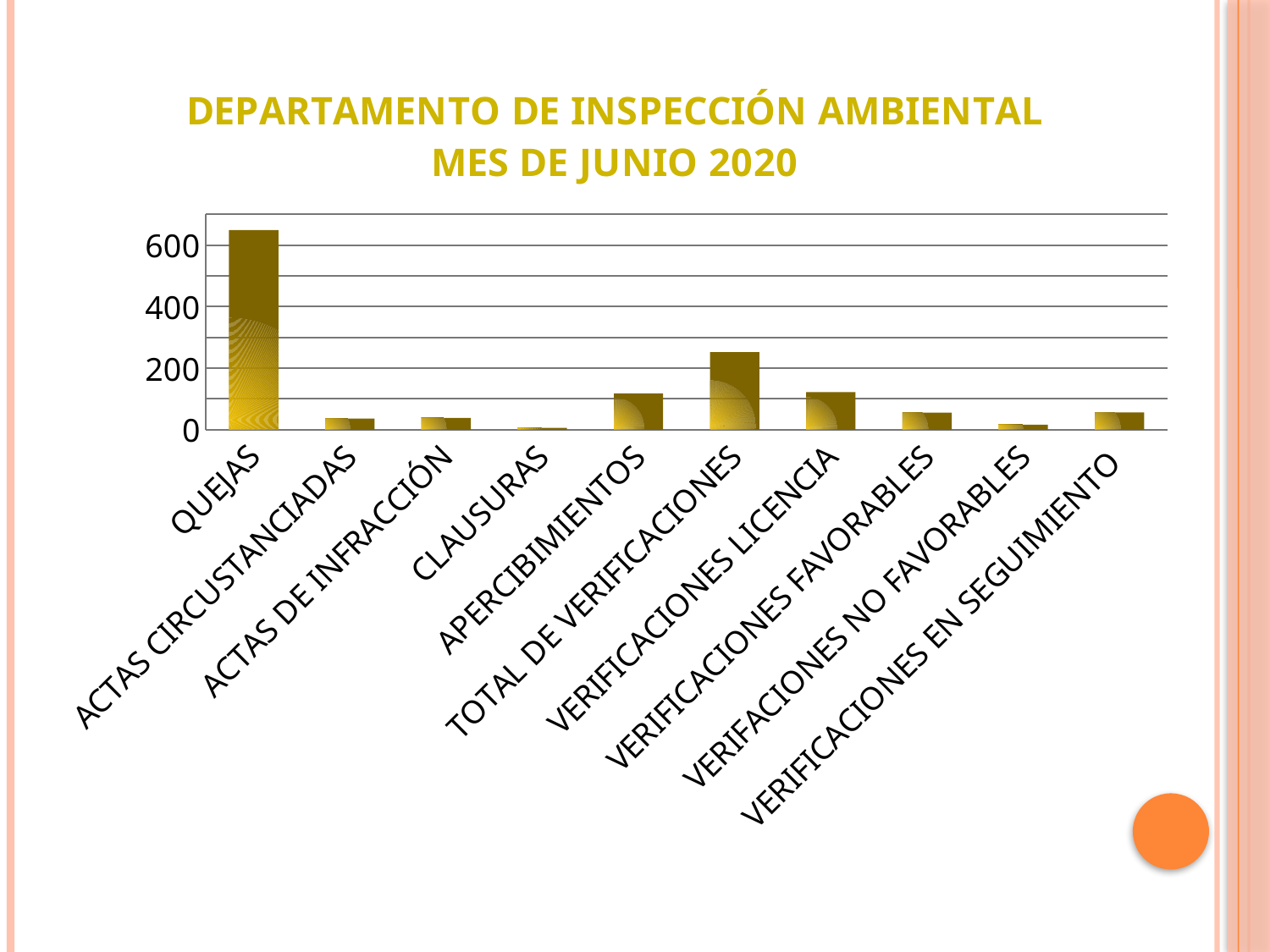
Is the value for TOTAL DE VERIFICACIONES greater or less than 200? greater Which is larger, the value for TOTAL DE VERIFICACIONES or the value for VERIFICACIONES LICENCIA? TOTAL DE VERIFICACIONES Which category has the lowest value? CLAUSURAS Is the value for QUEJAS greater or less than 600? greater Which is larger, the value for QUEJAS or the value for TOTAL DE VERIFICACIONES? QUEJAS What month and year does the chart title refer to? JUNIO 2020 How many categories are plotted on the chart? 10 Which category has the highest value? QUEJAS Is the value for APERCIBIMIENTOS greater or less than 200? less What kind of chart is shown on the slide? bar chart Which is larger, the value for APERCIBIMIENTOS or the value for CLAUSURAS? APERCIBIMIENTOS